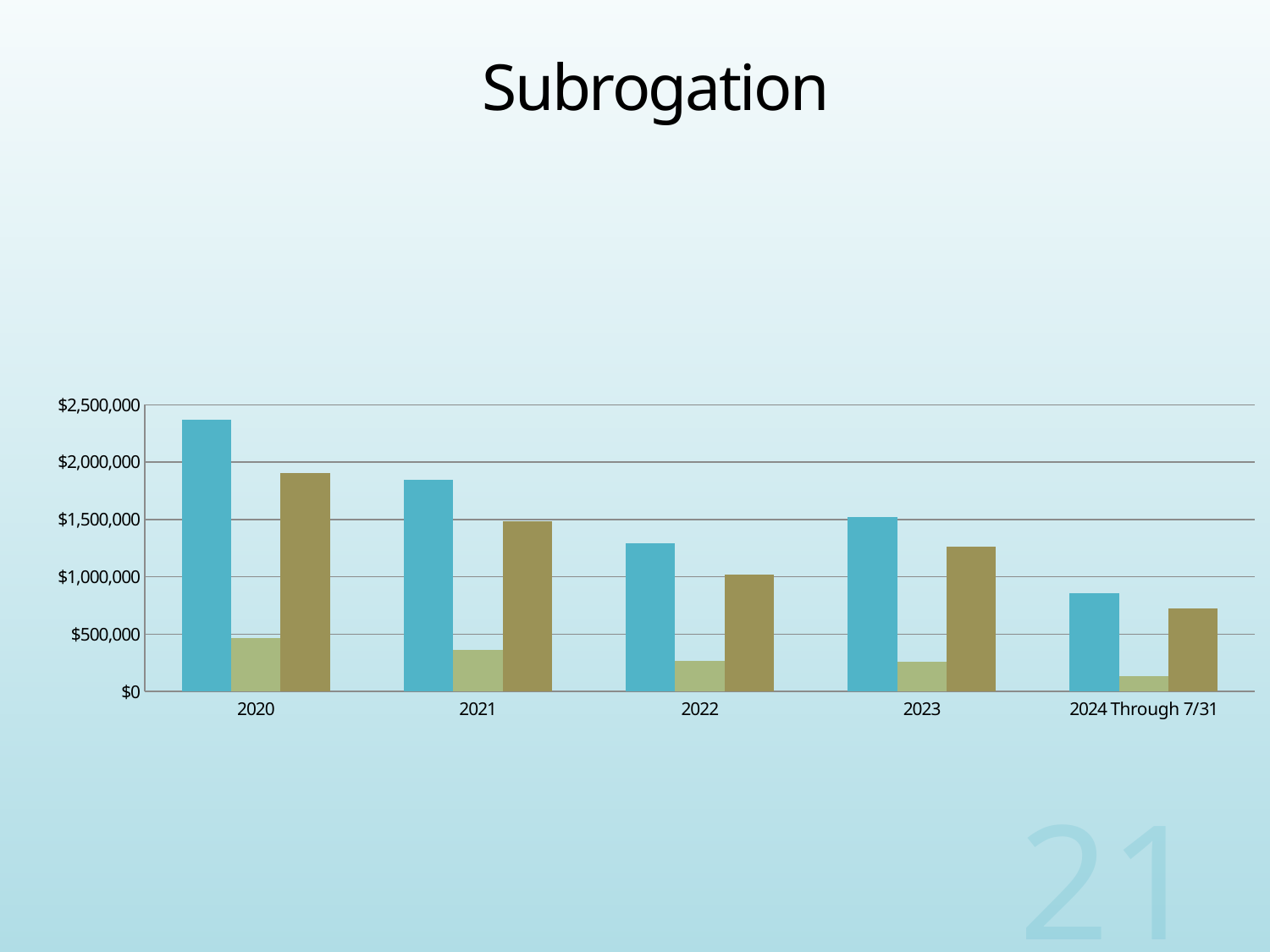
In which category is the blue bar the shortest? 2024 Through 7/31 In which category is the light green bar the shortest? 2024 Through 7/31 Is the blue bar for 2020 greater or less than $2,000,000? greater How many bars are plotted for each year category? 3 Is the blue bar for 2022 greater or less than $1,500,000? less How many year categories are shown on the x axis? 5 What is the title of the slide containing the chart? Subrogation In 2020, which is larger, the blue bar or the olive bar? the blue bar What kind of chart is shown on the slide? bar chart Do the light green bars rise or fall from 2020 to 2024 Through 7/31? fall Is the olive bar for 2023 greater or less than $1,000,000? greater In which year is the blue bar the tallest? 2020